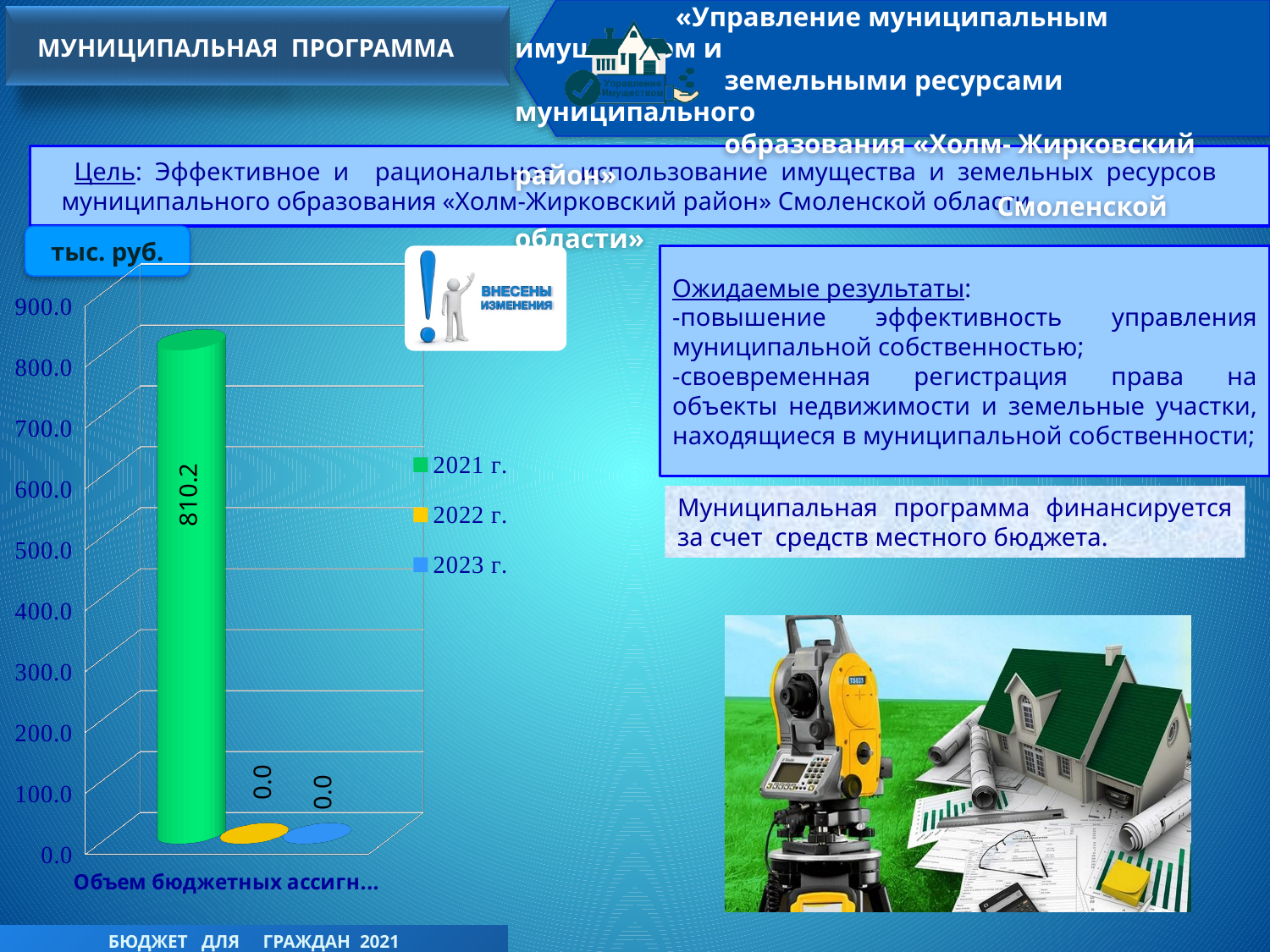
How many series does the chart legend list? 3 What colour is the bar for 2021 г. in the chart? green What is the value for 2022 г. in the chart? 0.0 Which is larger, the value for 2021 г. or the value for 2023 г.? 2021 г. Is the value for 2021 г. greater or less than 800.0? greater What is the difference between the values for 2021 г. and 2022 г.? 810.2 What is the value for 2023 г. in the chart? 0.0 What kind of chart is shown on the slide? bar chart What is the value for 2021 г. in the chart? 810.2 Is the value for 2021 г. greater or less than 900.0? less Which year has the highest value in the chart? 2021 г. What unit is shown for the chart values? тыс. руб.